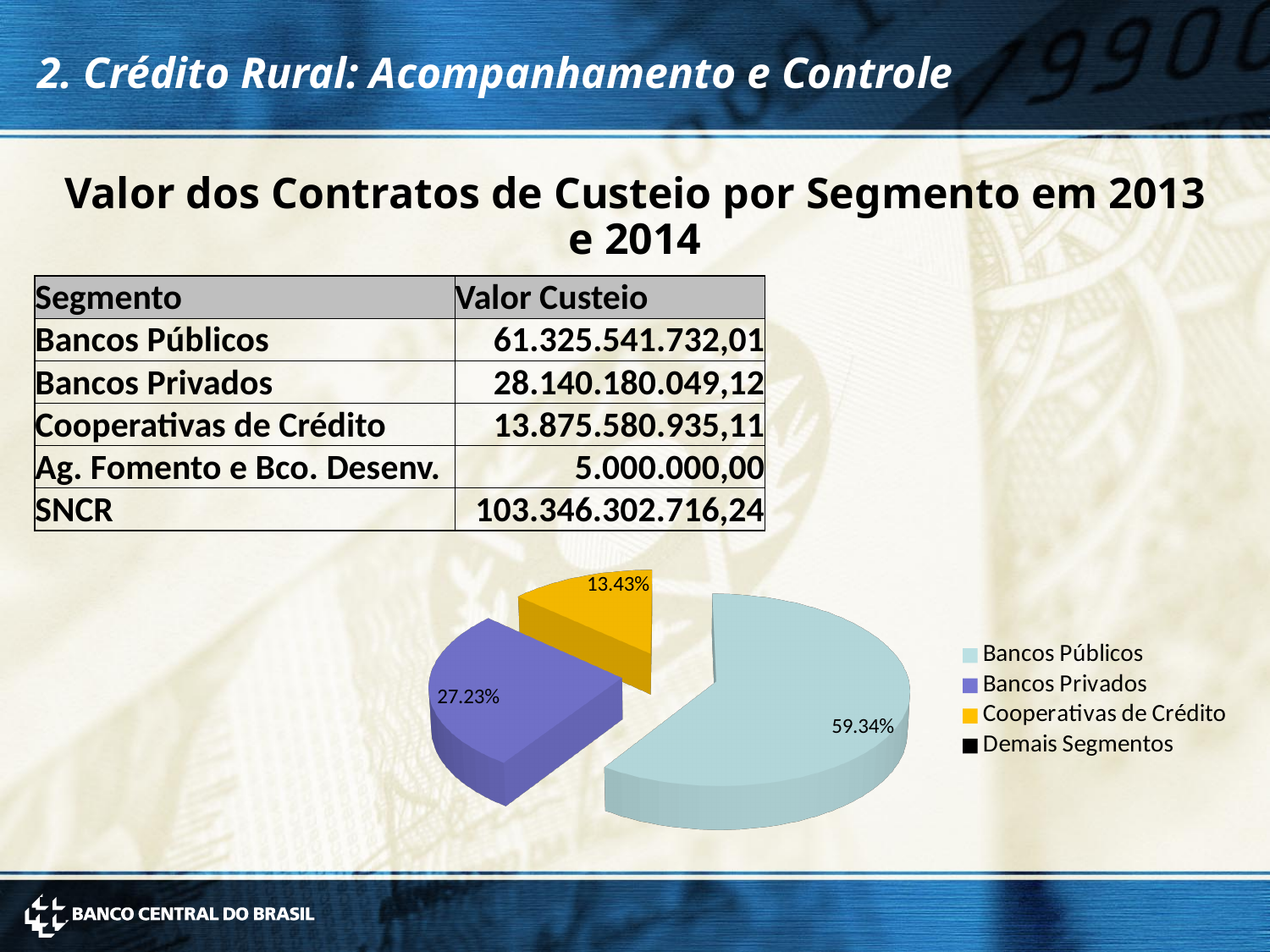
Is the share for Bancos Públicos greater or less than 50%? greater What share of the pie does Bancos Públicos represent? 59.34% What is the title shown above the table and pie chart? Valor dos Contratos de Custeio por Segmento em 2013 e 2014 What is the difference in percentage points between the Bancos Públicos slice and the Bancos Privados slice? 32.11 What is the difference in percentage points between the Bancos Privados slice and the Cooperativas de Crédito slice? 13.80 What colour is the Cooperativas de Crédito slice in the pie chart? Yellow Which slice is larger, Bancos Privados or Cooperativas de Crédito? Bancos Privados What share of the pie does Cooperativas de Crédito represent? 13.43% What share of the pie does Bancos Privados represent? 27.23% What kind of chart is shown on the slide? Pie chart How many entries does the pie chart legend list? 4 Which segment has the largest slice of the pie? Bancos Públicos